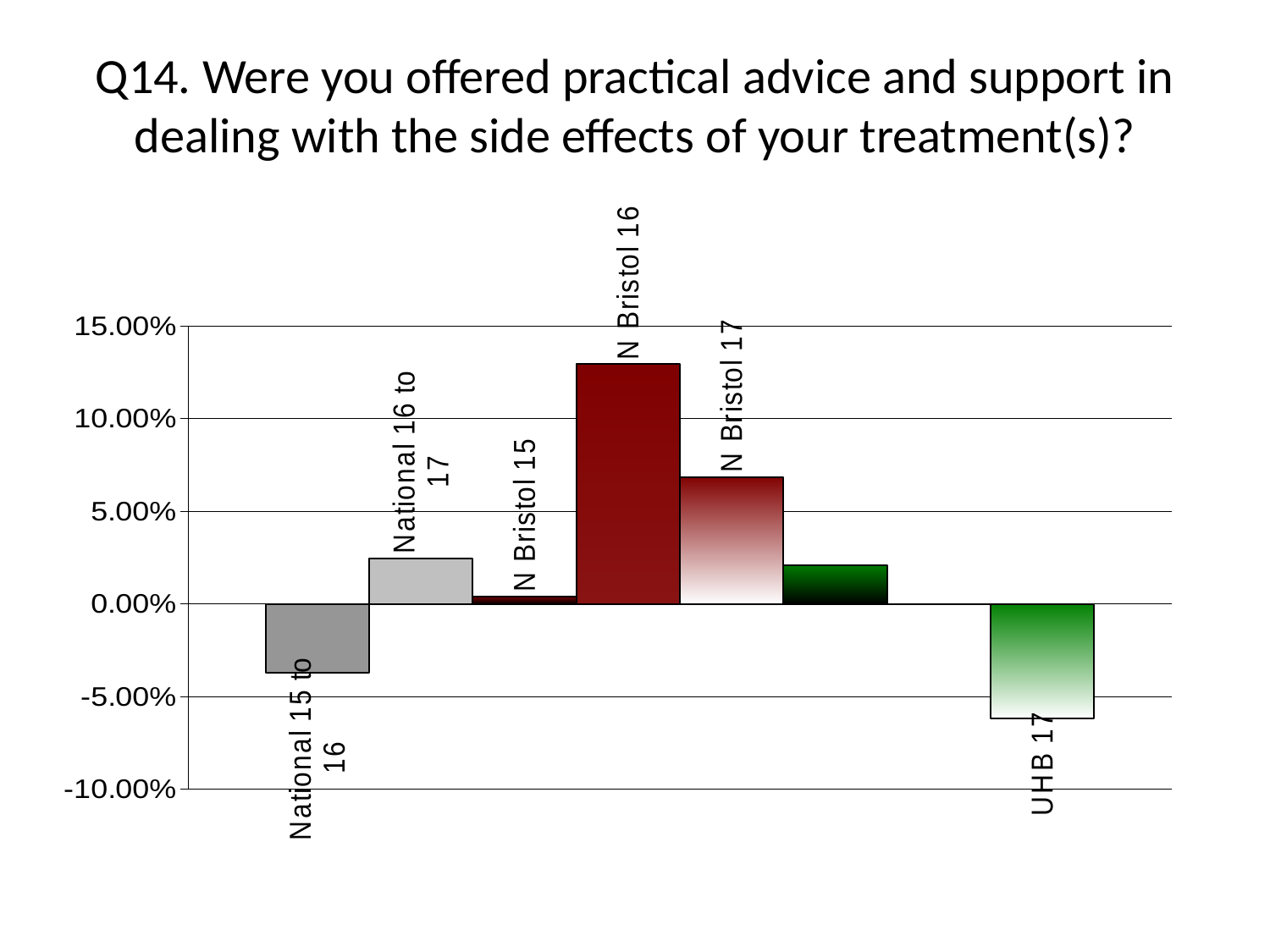
Is the value for N Bristol 16 greater or less than 10.00%? greater Which category has the lowest value? UHB 17 How many bars are plotted in the chart? 7 Is the value for National 15 to 16 greater or less than 0.00%? less Is the value for N Bristol 17 greater or less than 5.00%? greater Which category has the highest value? N Bristol 16 Which is larger, the value for National 15 to 16 or the value for UHB 17? National 15 to 16 What kind of chart is shown on the slide? bar chart Which is larger, the value for N Bristol 16 or the value for N Bristol 17? N Bristol 16